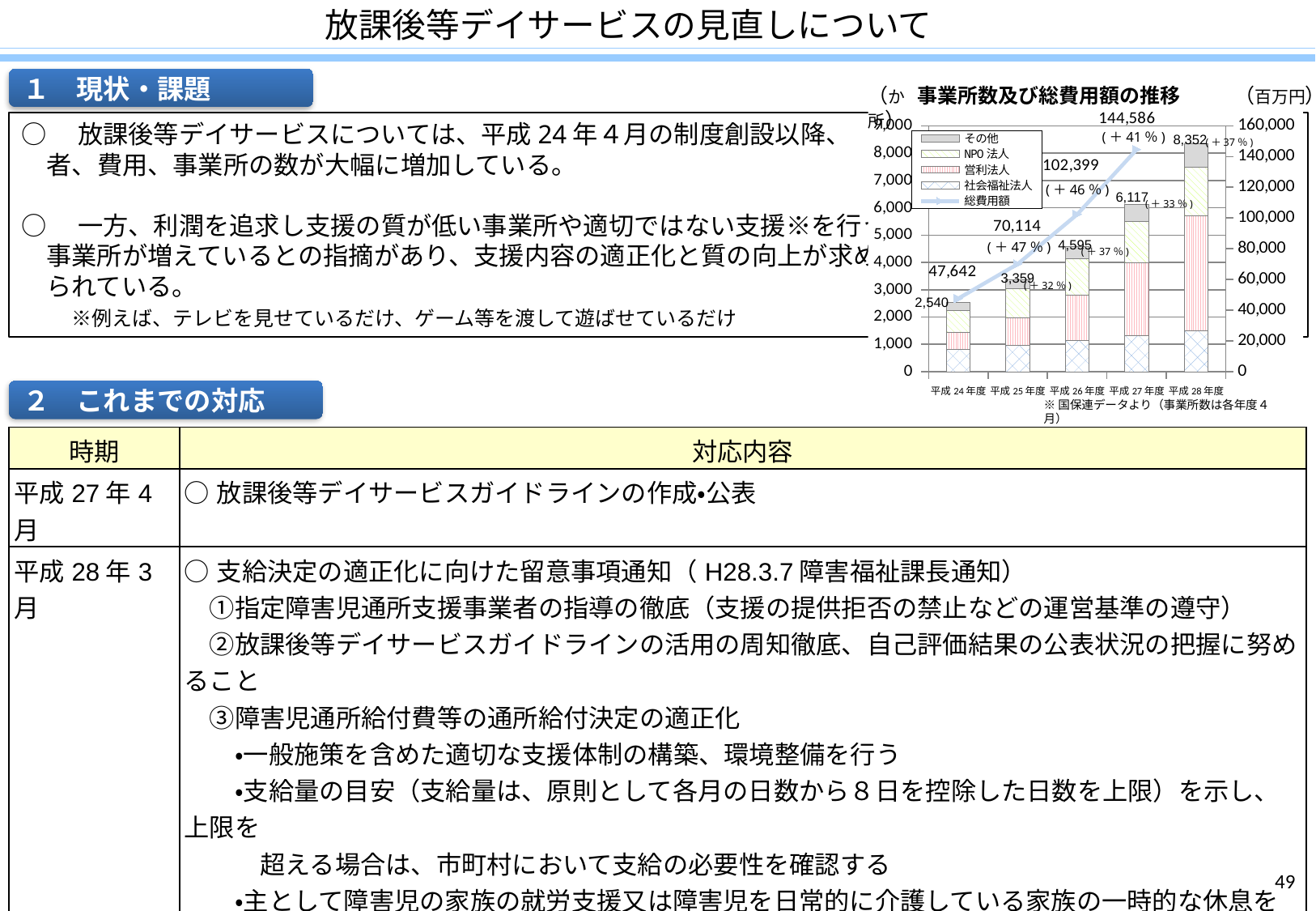
What is the number of establishments (事業所数) for 平成28年度? 8,352 How many entries does the chart's legend list? 5 What is the total cost (総費用額) labelled with (+47%) on the chart? 70,114 What is the number of establishments (事業所数) for 平成26年度? 4,595 What type of chart is shown on the slide? Stacked bar chart with a line What is the difference in the number of establishments between 平成28年度 and 平成27年度? 2,235 Which fiscal year has the lowest number of establishments? 平成24年度 What is the number of establishments (事業所数) for 平成24年度? 2,540 What is the title of the chart on the slide? 事業所数及び総費用額の推移 Which fiscal year has the highest number of establishments? 平成28年度 How many fiscal years are shown on the x axis of the chart? 5 Does the number of establishments rise or fall from 平成24年度 to 平成28年度? Rise